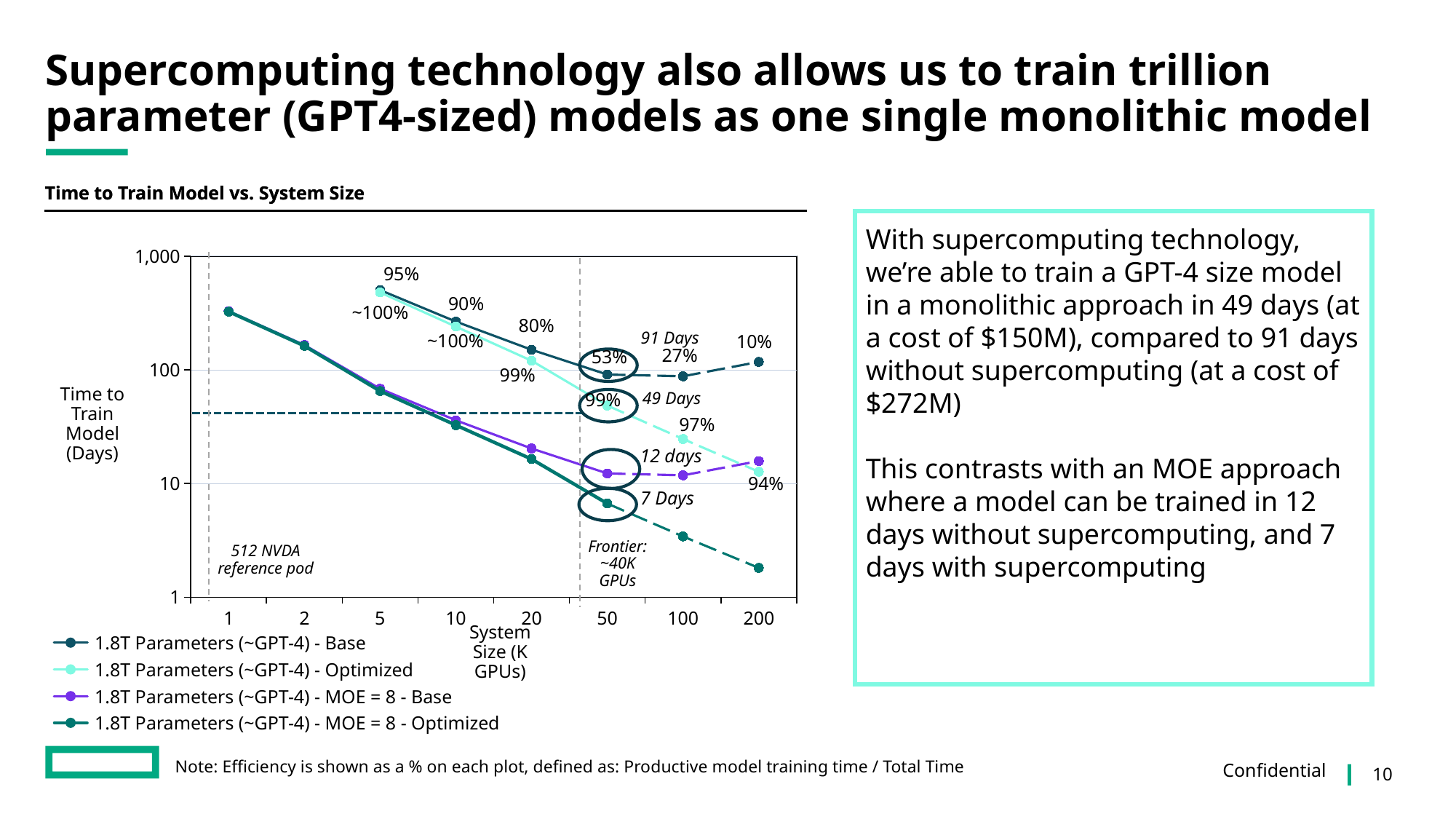
Is the time to train for the 1.8T Parameters (~GPT-4) - MOE = 8 - Optimized series at 200K GPUs greater or less than 10 days? less What kind of chart is shown on the slide? Line chart What efficiency percentage is shown for the 1.8T Parameters (~GPT-4) - Base series at 200K GPUs? 10% According to the chart, how many days does the 1.8T Parameters (~GPT-4) - MOE = 8 - Optimized series take at 50K GPUs? 7 Days What is the difference in training days between the Base series (91 Days) and the Optimized series (49 Days) at 50K GPUs? 42 days At 50K GPUs, which series has the lowest time to train? 1.8T Parameters (~GPT-4) - MOE = 8 - Optimized According to the chart, how many days does the 1.8T Parameters (~GPT-4) - Optimized series take to train at 50K GPUs? 49 Days How many system-size points are marked on the x axis of the chart? 8 How many series does the legend of the chart list? 4 Does the time to train for the 1.8T Parameters (~GPT-4) - MOE = 8 - Optimized series rise or fall as system size increases? Fall At 50K GPUs, which takes longer to train: the MOE = 8 - Base series or the MOE = 8 - Optimized series? MOE = 8 - Base According to the chart, how many days does the 1.8T Parameters (~GPT-4) - Base series take to train at 50K GPUs? 91 Days